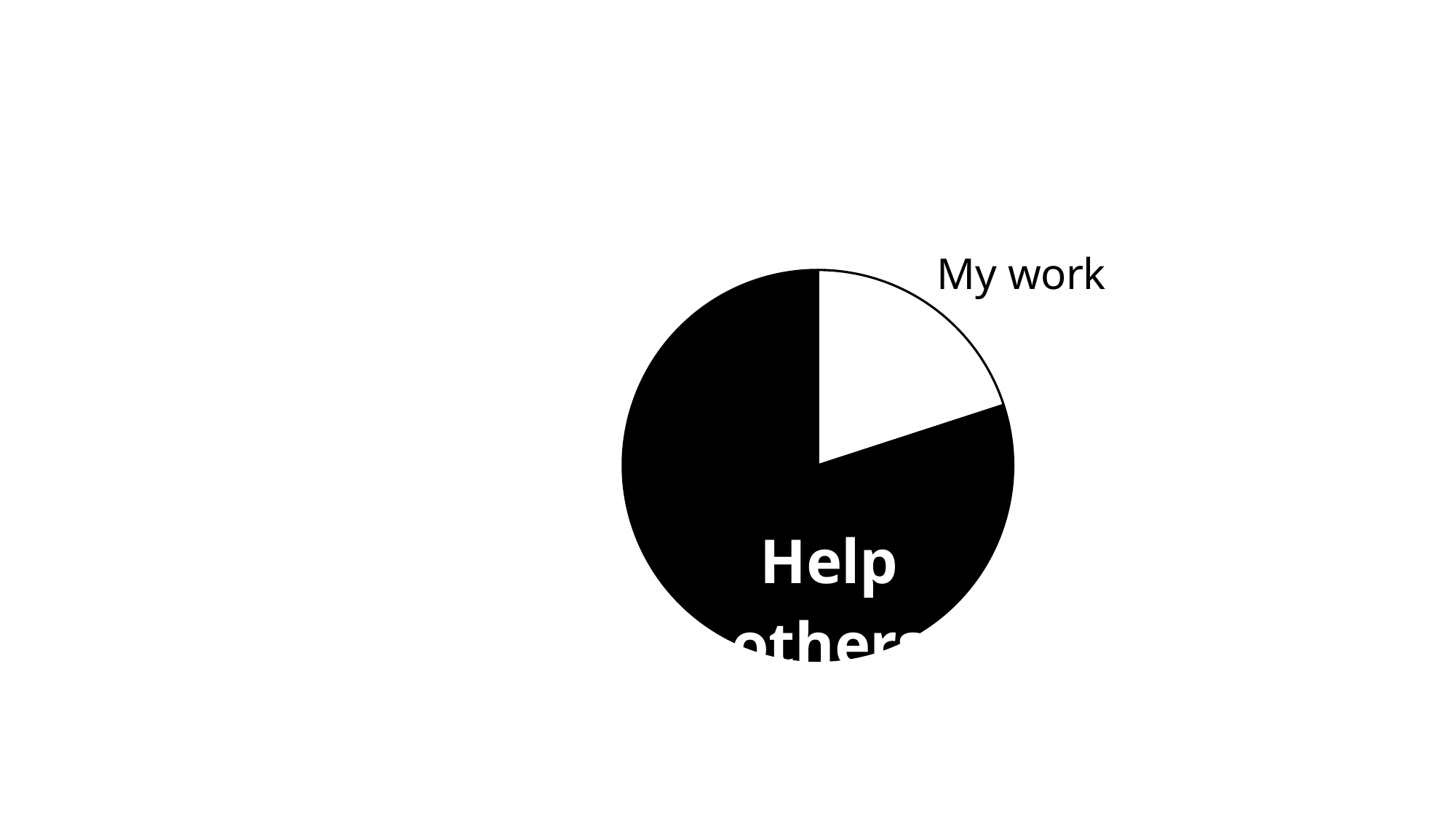
What colour is the "Help others" slice of the pie chart? black Which slice of the pie chart is the smallest? My work Which slice of the pie chart is the largest? Help others What kind of chart is shown on the slide? pie chart What colour is the "My work" slice of the pie chart? white How many slices does the pie chart have? 2 Which slice is larger, "My work" or "Help others"? Help others